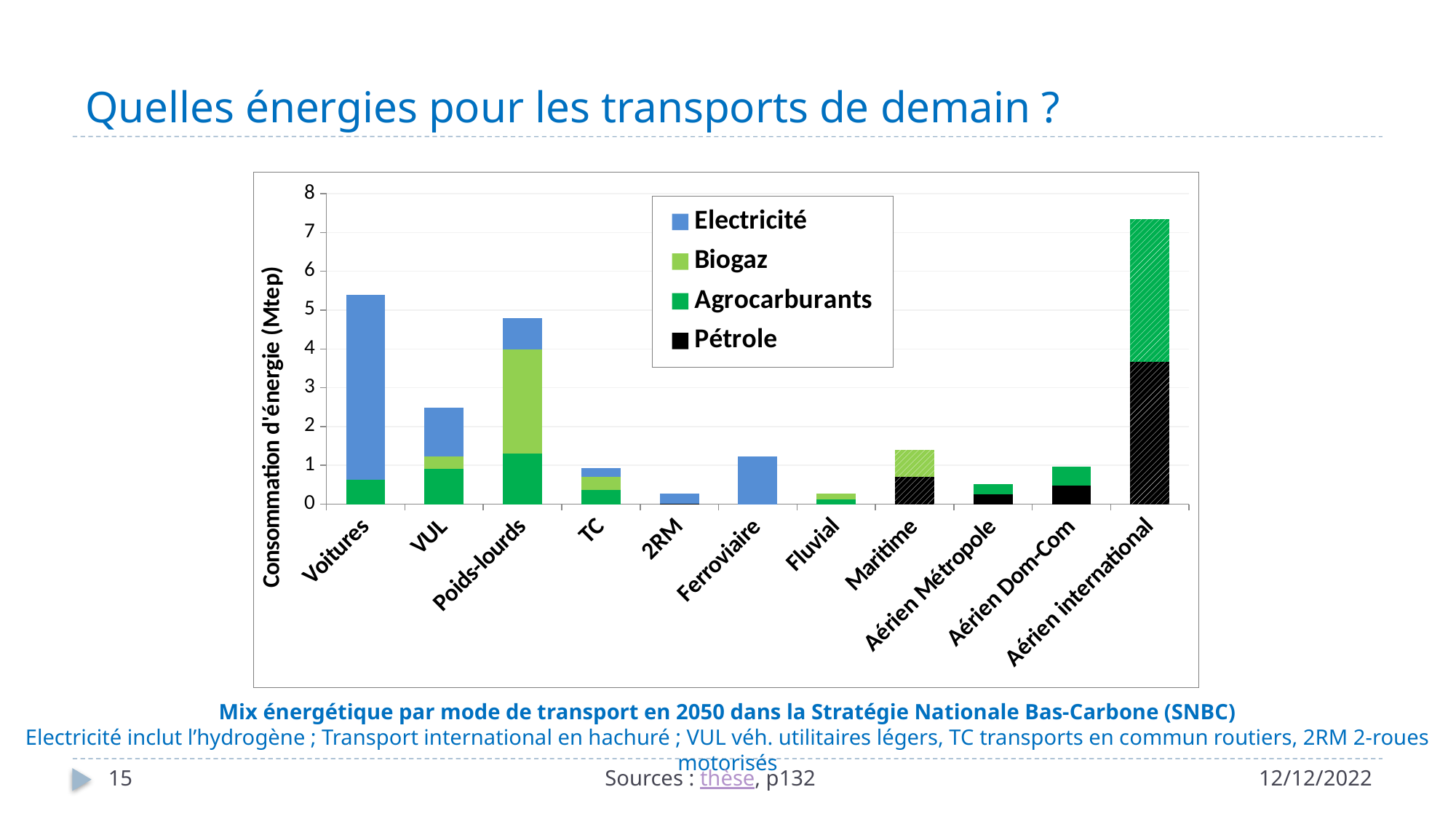
What is the label of the y axis? Consommation d'énergie (Mtep) How many transport modes (categories) are shown on the x axis? 11 Is the total value for Voitures greater or less than 5? greater Is the total value for Poids-lourds greater or less than 5? less Is the total value for VUL greater or less than 2? greater Which series is shown in black in the legend? Pétrole How many series does the legend list? 4 Which transport mode has the highest total energy consumption? Aérien international What kind of chart is shown on the slide? Stacked bar chart Which has a larger total energy consumption, Voitures or Poids-lourds? Voitures